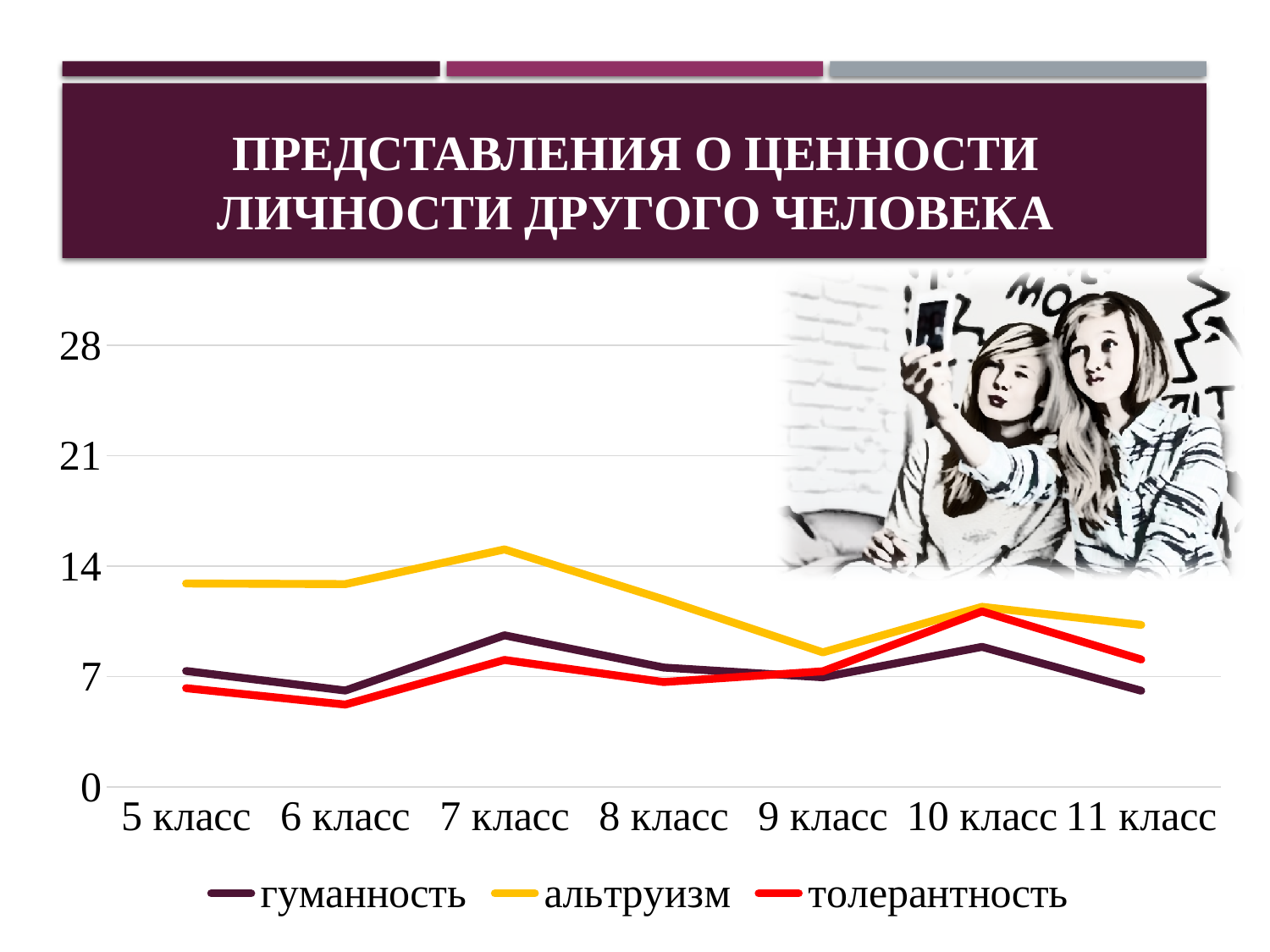
Is the value for толерантность in 6 класс greater or less than 7? less In 10 класс, which is larger: толерантность or гуманность? толерантность Which series is drawn in yellow? альтруизм In which class does the альтруизм line reach its lowest value? 9 класс In which class does the альтруизм line reach its highest value? 7 класс How many classes (categories) are shown on the x axis? 7 Is the value for альтруизм in 7 класс greater or less than 14? greater Does the альтруизм line rise or fall from 7 класс to 9 класс? fall In which class does the толерантность line reach its lowest value? 6 класс How many series does the legend list? 3 Is the value for гуманность in 7 класс greater or less than 7? greater What kind of chart is shown on the slide? line chart